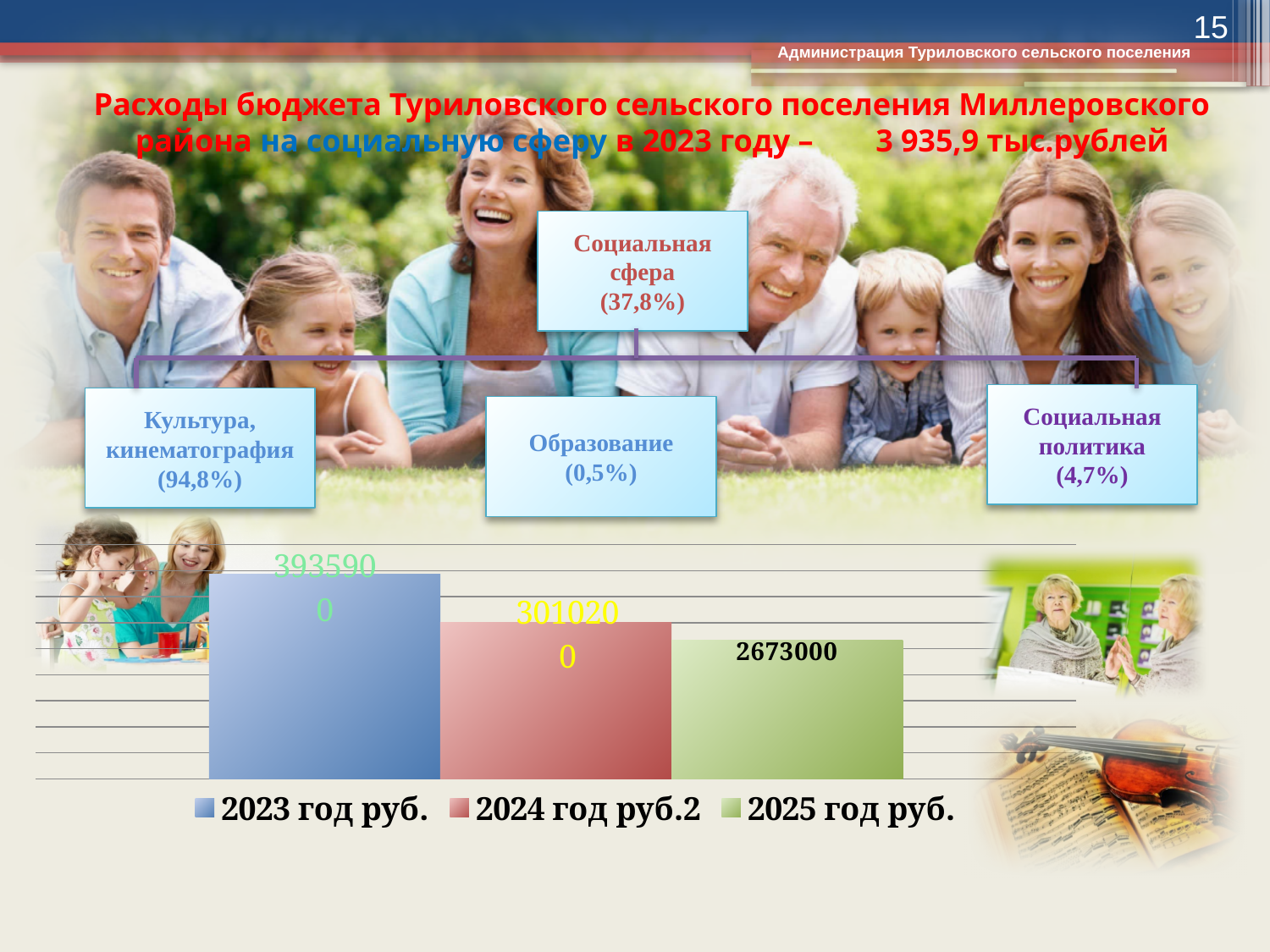
Do the values rise or fall from the 2023 bar to the 2025 bar? fall Which series has the lowest value in the chart? 2025 год руб. What is the difference between the 2023 год руб. value and the 2025 год руб. value? 1262900 Which series has the highest value in the chart? 2023 год руб. What is the difference between the 2024 год руб.2 value and the 2025 год руб. value? 337200 How many bars are plotted in the chart? 3 What is the value shown for the 2025 год руб. bar? 2673000 Which is larger, the value for 2023 год руб. or the value for 2024 год руб.2? 2023 год руб. How many series does the chart legend list? 3 What is the value shown for the 2024 год руб.2 bar? 3010200 What kind of chart is shown on the slide? bar chart What is the value shown for the 2023 год руб. bar? 3935900